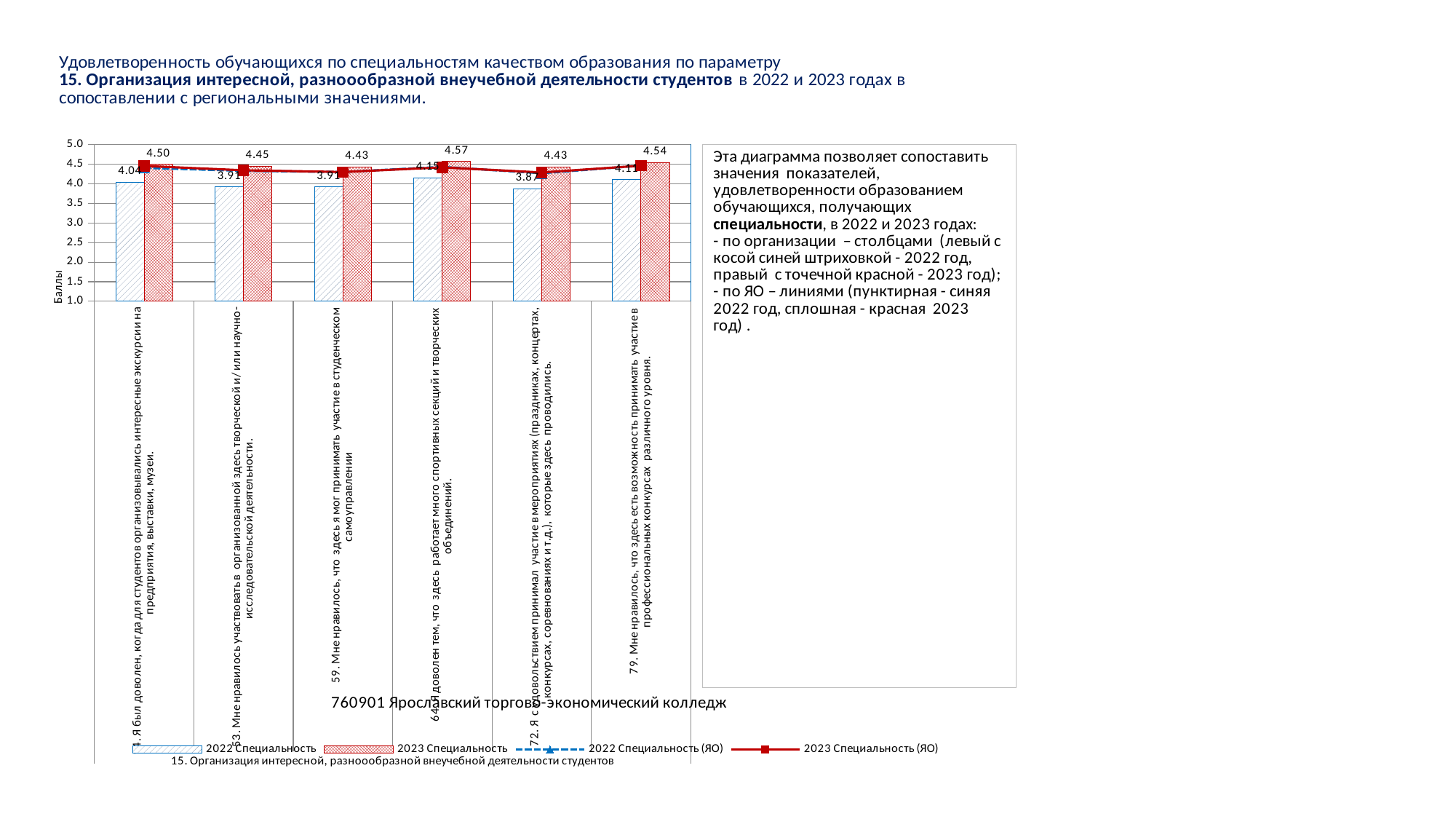
What is the 2023 Специальность value for question 4 (Я был доволен, когда для студентов организовывались интересные экскурсии)? 4.50 How many series does the chart legend list? 4 What is the 2022 Специальность value for question 72 (Я с удовольствием принимал участие в мероприятиях)? 3.87 Is the 2022 Специальность value for question 53 greater or less than 4.0? less What is the difference between the 2023 and 2022 Специальность values for question 4? 0.46 Which is larger: the 2022 Специальность value for question 4 or for question 79? Question 79 (4.11) What is the 2023 Специальность value for question 64 (Я доволен тем, что здесь работает много спортивных секций и творческих объединений)? 4.57 What is the label of the vertical axis of the chart? Баллы Which question has the lowest 2022 Специальность bar? 72. Я с удовольствием принимал участие в мероприятиях (праздниках, концертах, конкурсах, соревнованиях и т.д.), которые здесь проводились. How many questions (categories) are shown on the x axis of the chart? 6 Which question has the highest 2023 Специальность bar? 64. Я доволен тем, что здесь работает много спортивных секций и творческих объединений. Which question has the highest 2022 Специальность bar? 64. Я доволен тем, что здесь работает много спортивных секций и творческих объединений.